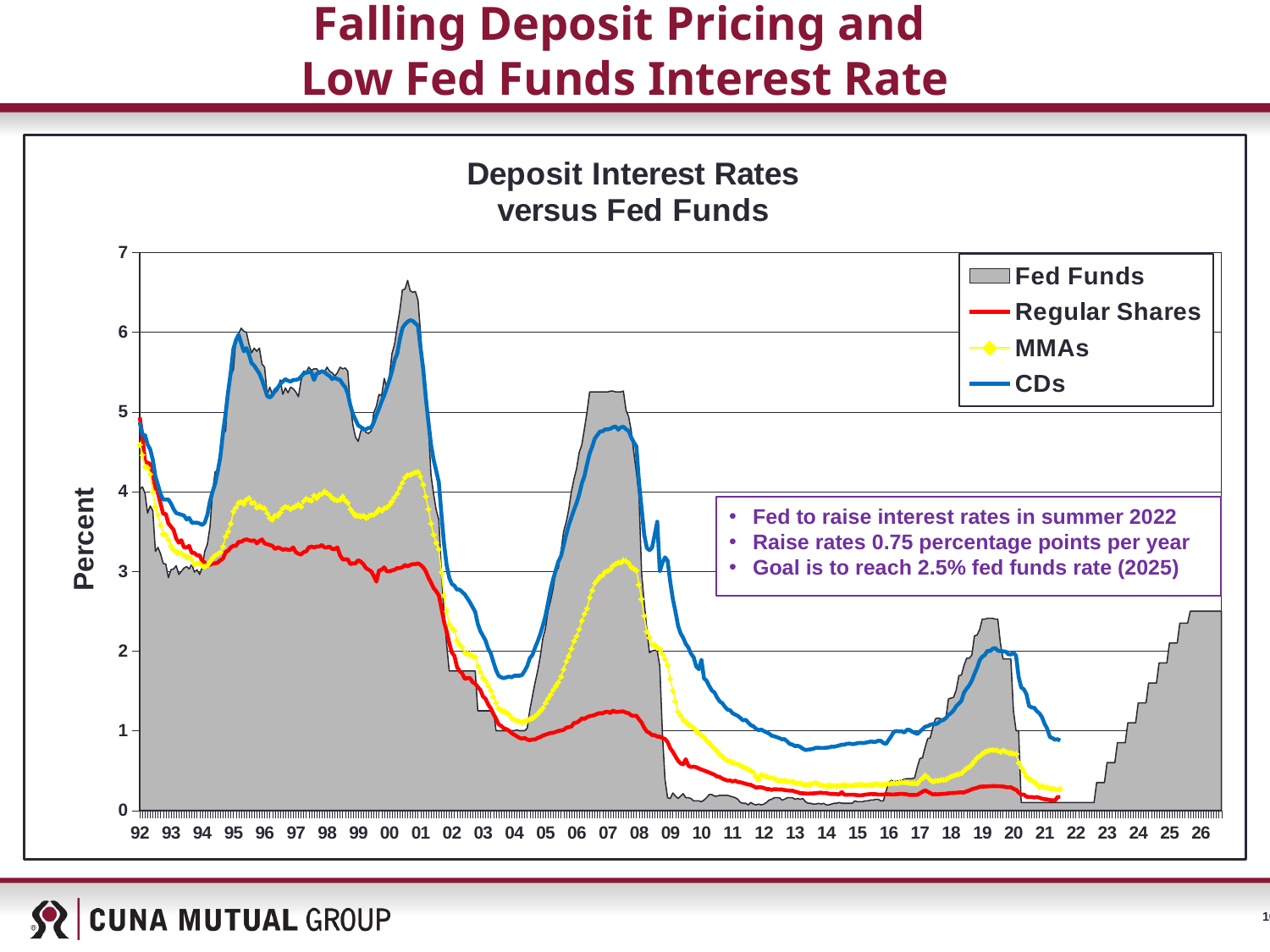
What is the title of the chart? Deposit Interest Rates versus Fed Funds Is the Fed Funds value in 2007 greater or less than 4? greater In 2007, which is higher, MMAs or Regular Shares? MMAs Which series is the lowest in 2019? Regular Shares Is the MMAs value in 2013 greater or less than 1? less How many series does the chart legend list? 4 Do the CDs values rise or fall from 2007 to 2009? fall Is the Regular Shares value in 2021 greater or less than 1? less What is the label on the vertical axis of the chart? Percent In 2019, which is higher, CDs or Regular Shares? CDs